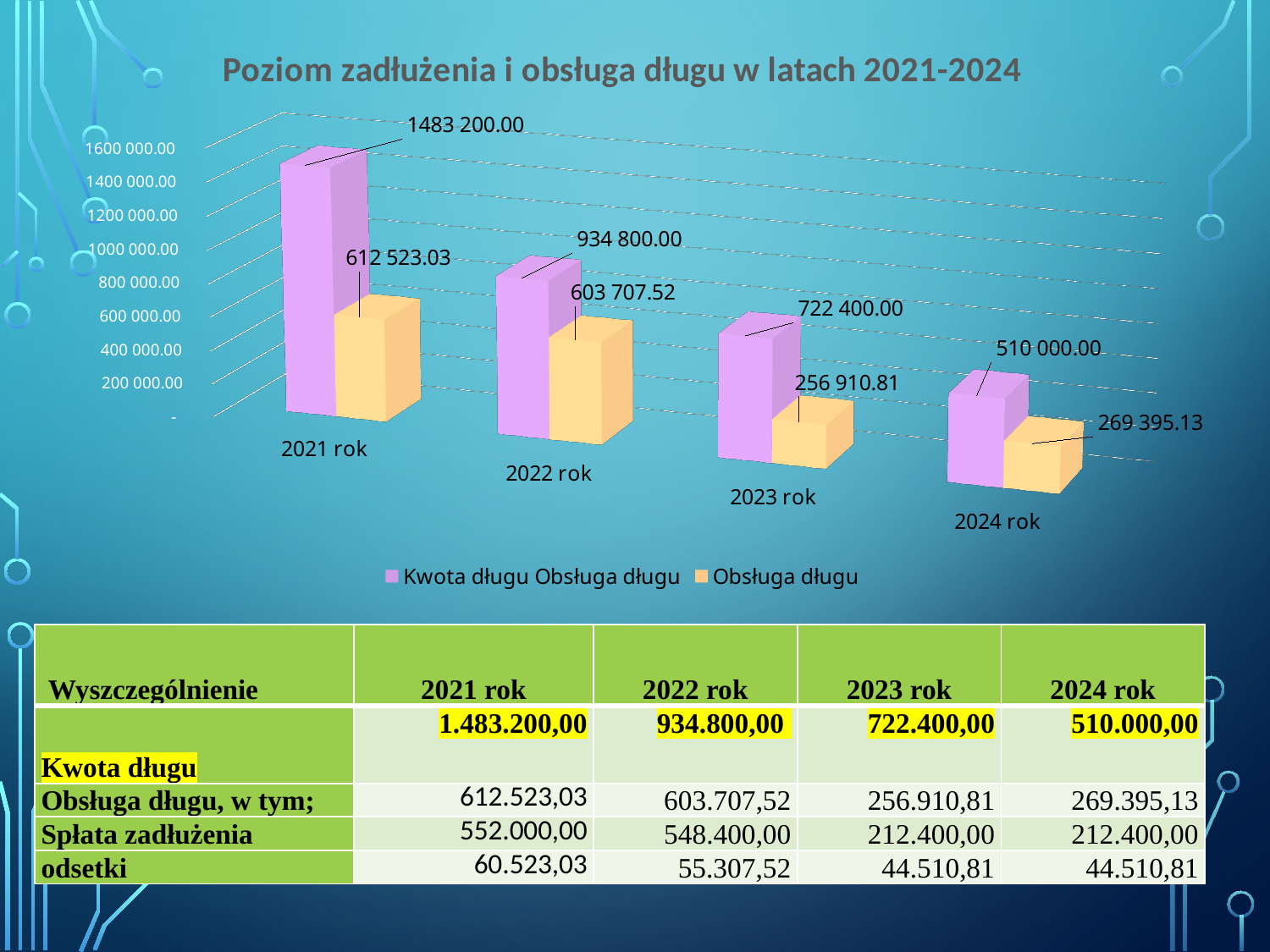
What is the value of the purple (Kwota długu) bar for 2023 rok? 722 400.00 How many years (categories) are shown on the x axis of the chart? 4 What is the value of the orange (Obsługa długu) bar for 2024 rok? 269 395.13 Which is larger: the orange bar for 2021 rok or the orange bar for 2022 rok? 2021 rok What type of chart is shown on the slide? Bar chart Which year has the lowest orange (Obsługa długu) bar? 2023 rok What is the value of the orange (Obsługa długu) bar for 2022 rok? 603 707.52 How many series does the chart legend list? 2 Do the purple (Kwota długu) bar values rise or fall from 2021 rok to 2024 rok? Fall Which year has the highest purple (Kwota długu) bar? 2021 rok What is the value of the purple (Kwota długu) bar for 2021 rok? 1483 200.00 What is the difference between the purple bar values for 2022 rok and 2023 rok? 212 400.00